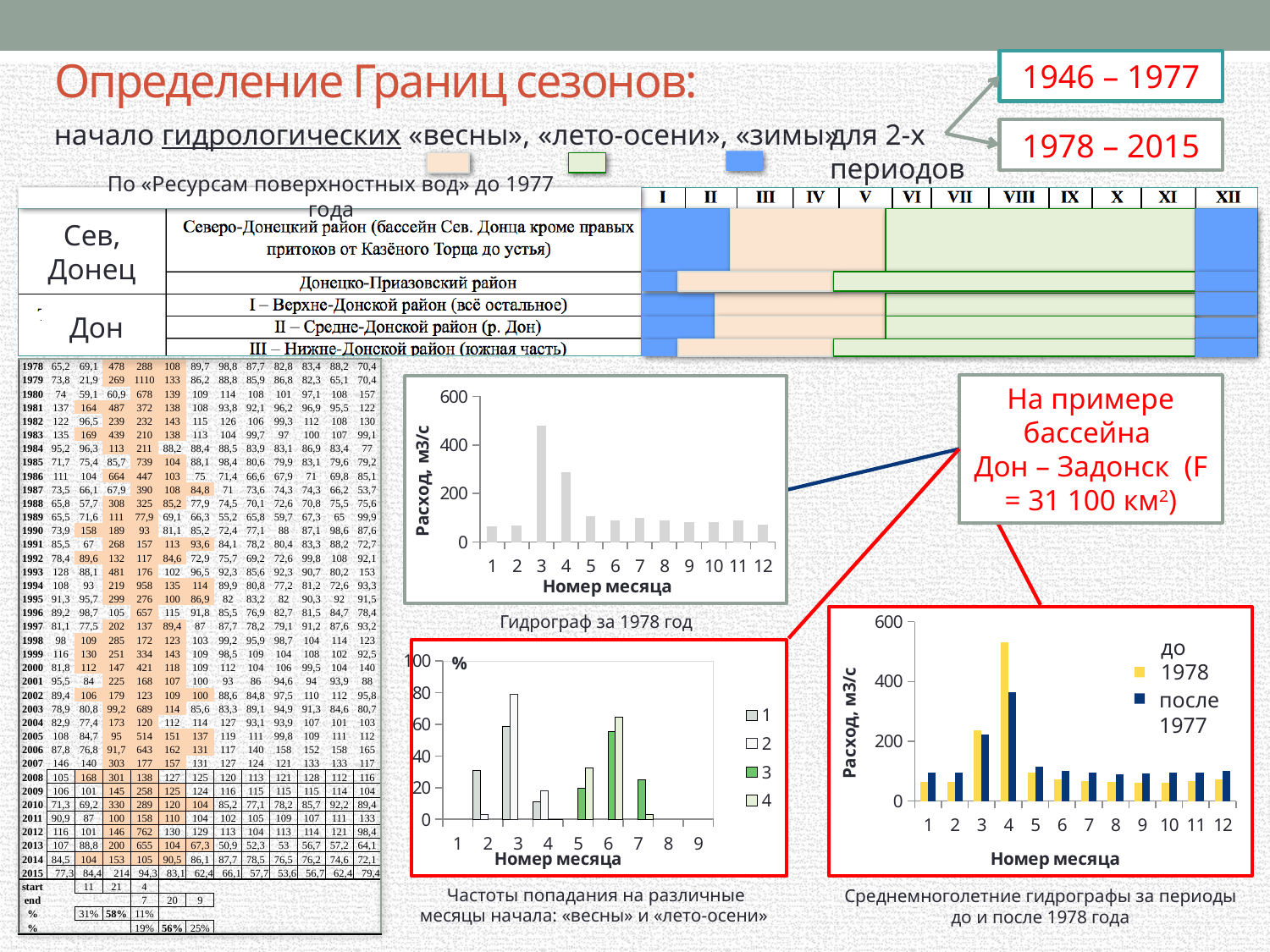
In the 'Гидрограф за 1978 год' chart, is the value for month 1 greater or less than 200? less In the bottom-right chart, is the 'до 1978' value for month 4 greater or less than 400? greater In the 'Гидрограф за 1978 год' chart, which month number has the highest value? 3 In the 'Гидрограф за 1978 год' chart, is the value for month 3 greater or less than 400? greater In the bottom-right chart, which month number has the highest value for the 'до 1978' series? 4 How many month categories are shown on the x axis of the 'Гидрограф за 1978 год' chart? 12 What is the y-axis title of the 'Гидрограф за 1978 год' chart? Расход, м3/с What kind of chart is the 'Гидрограф за 1978 год' chart? bar chart How many series does the legend list in the bottom-right chart 'Среднемноголетние гидрографы за периоды до и после 1978 года'? 2 In the bottom-right chart, for month 4, which series has the larger value: 'до 1978' or 'после 1977'? до 1978 How many series does the legend list in the bottom-middle chart 'Частоты попадания на различные месяцы начала'? 4